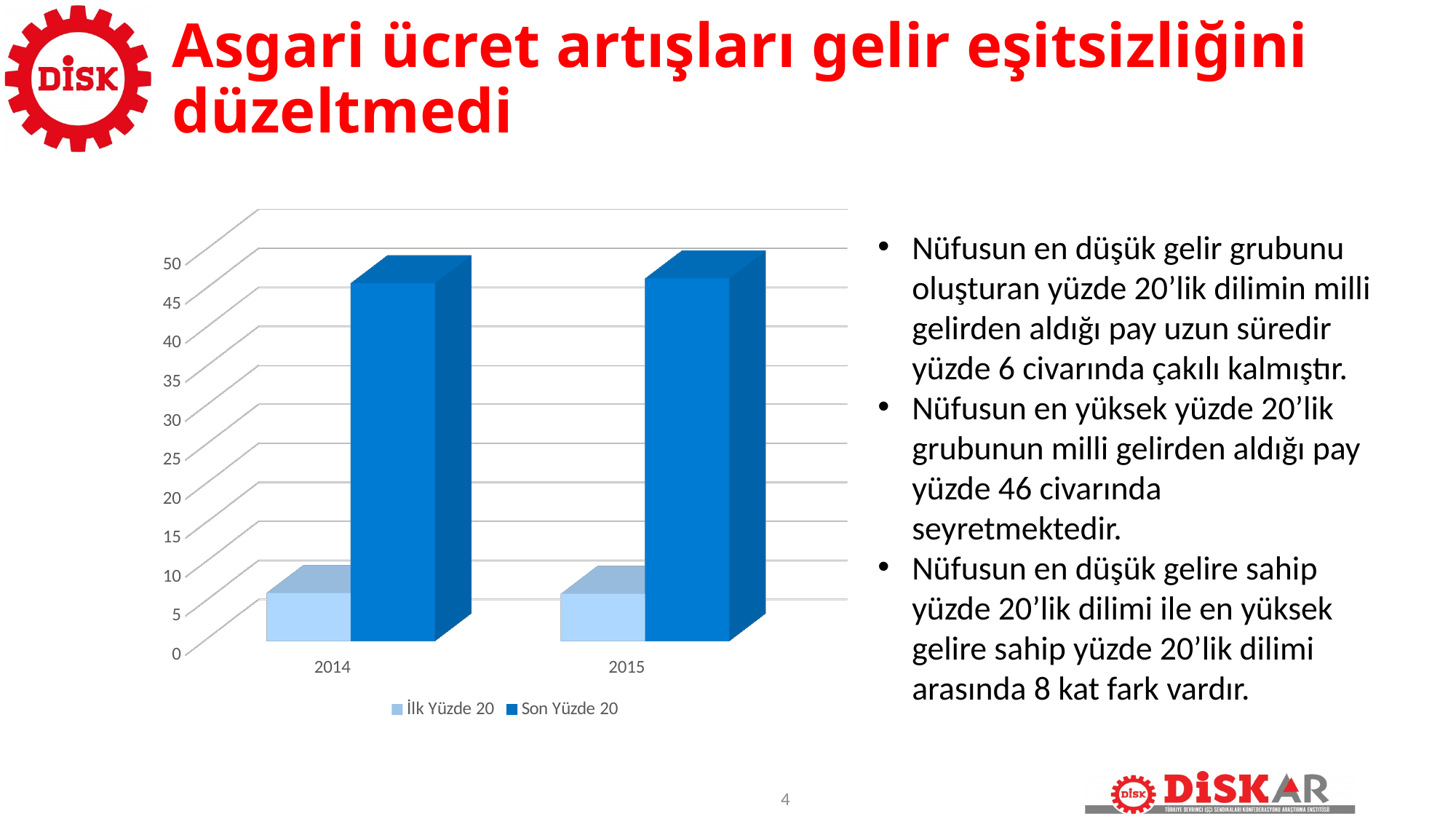
How many years are shown on the x axis of the chart? 2 Is the value for Son Yüzde 20 in 2014 greater or less than 40? greater Is the value for Son Yüzde 20 in 2015 greater or less than 50? less What are the two series names listed in the chart legend? İlk Yüzde 20 and Son Yüzde 20 How many series does the chart legend list? 2 Which series is larger in 2015, İlk Yüzde 20 or Son Yüzde 20? Son Yüzde 20 Which series is drawn in the darker blue colour in the chart? Son Yüzde 20 Which series is larger in 2014, İlk Yüzde 20 or Son Yüzde 20? Son Yüzde 20 Is the value for İlk Yüzde 20 in 2014 greater or less than 10? less What kind of chart is shown on the slide? bar chart